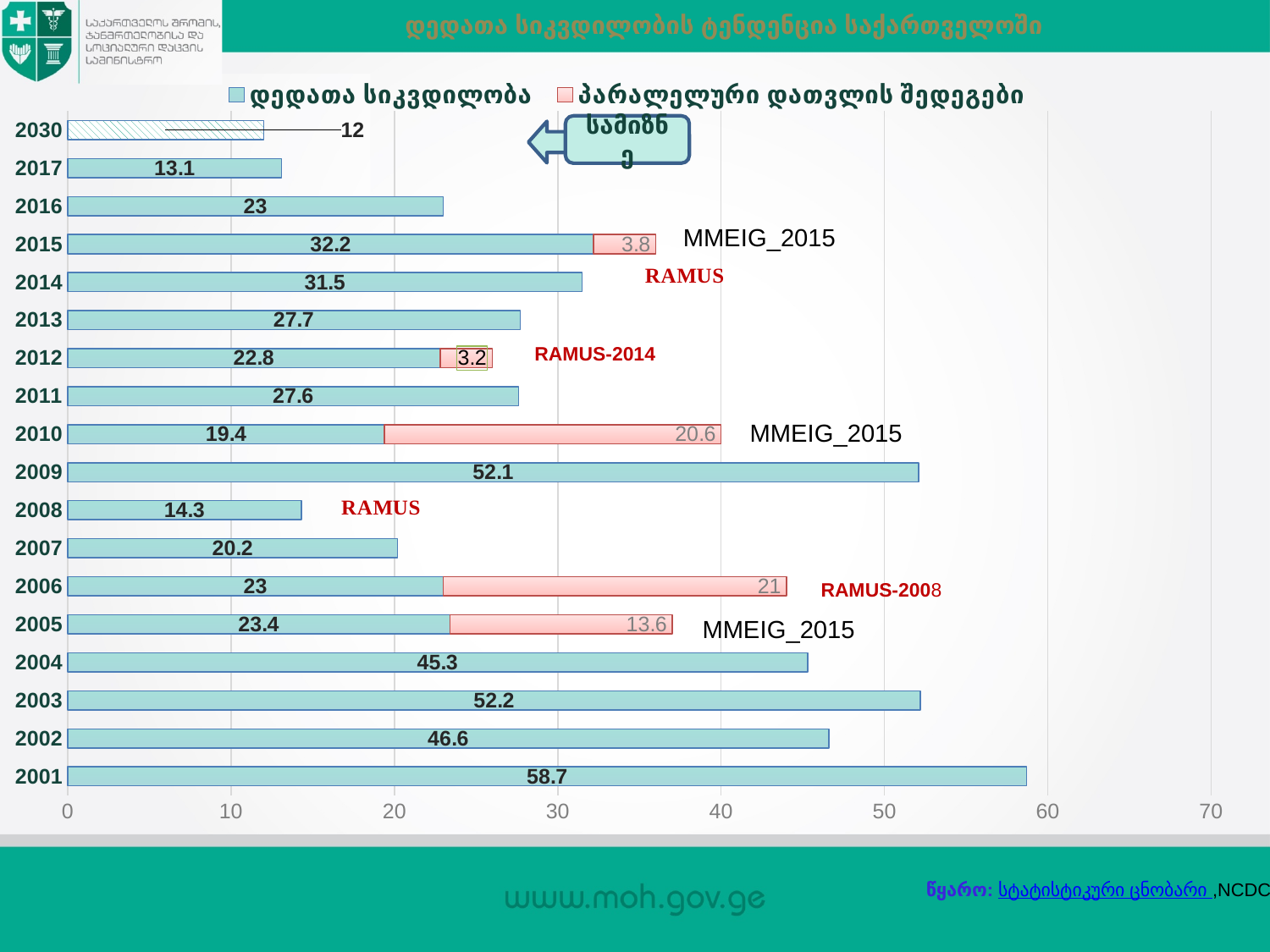
What is the difference between the maternal mortality values for 2001 and 2017? 45.6 What is the maternal mortality value for 2017? 13.1 What is the total of the stacked bar for 2006? 44 What is the value of the parallel count series (პარალელური დათვლის შედეგები) for 2010? 20.6 How many series does the legend list? 2 What is the total of the stacked bar for 2010? 40 What kind of chart is shown on the slide? Bar chart What is the maternal mortality value (დედათა სიკვდილობა) for 2001? 58.7 Which year has the highest maternal mortality value? 2001 How many categories (years) are shown on the chart? 18 Which year has the larger maternal mortality value, 2014 or 2013? 2014